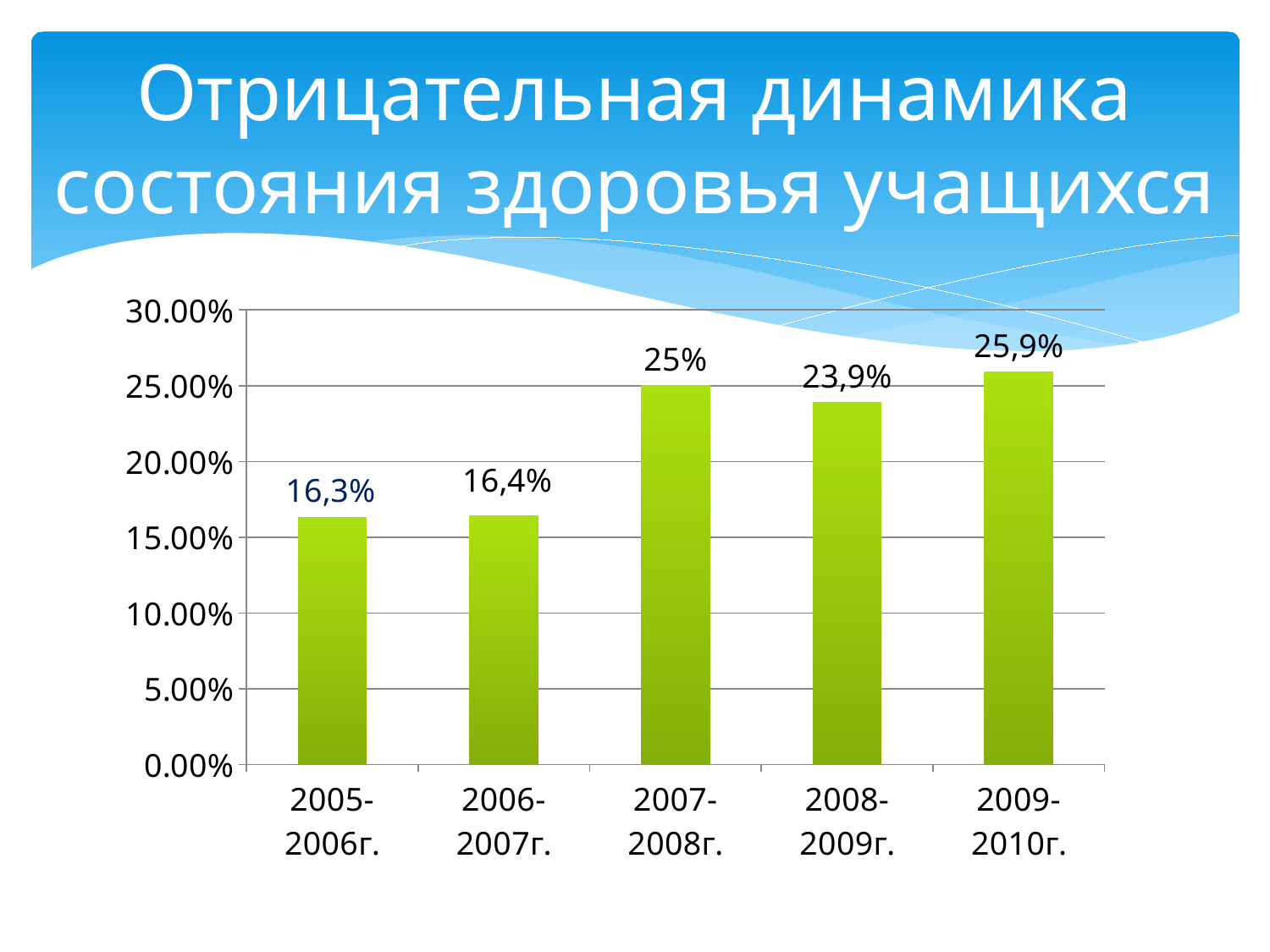
What is the difference between the values for 2009-2010г. and 2005-2006г.? 9,6% Is the value for 2008-2009г. greater or less than 20.00%? greater What is the value for 2008-2009г.? 23,9% What is the value for 2005-2006г.? 16,3% What kind of chart is shown on the slide? bar chart What is the difference between the values for 2007-2008г. and 2008-2009г.? 1,1% Which is larger, the value for 2007-2008г. or the value for 2008-2009г.? 2007-2008г. What is the value for 2007-2008г.? 25% What is the value for 2009-2010г.? 25,9% Which period has the highest value? 2009-2010г. Which period has the lowest value? 2005-2006г. How many periods are shown on the x axis? 5